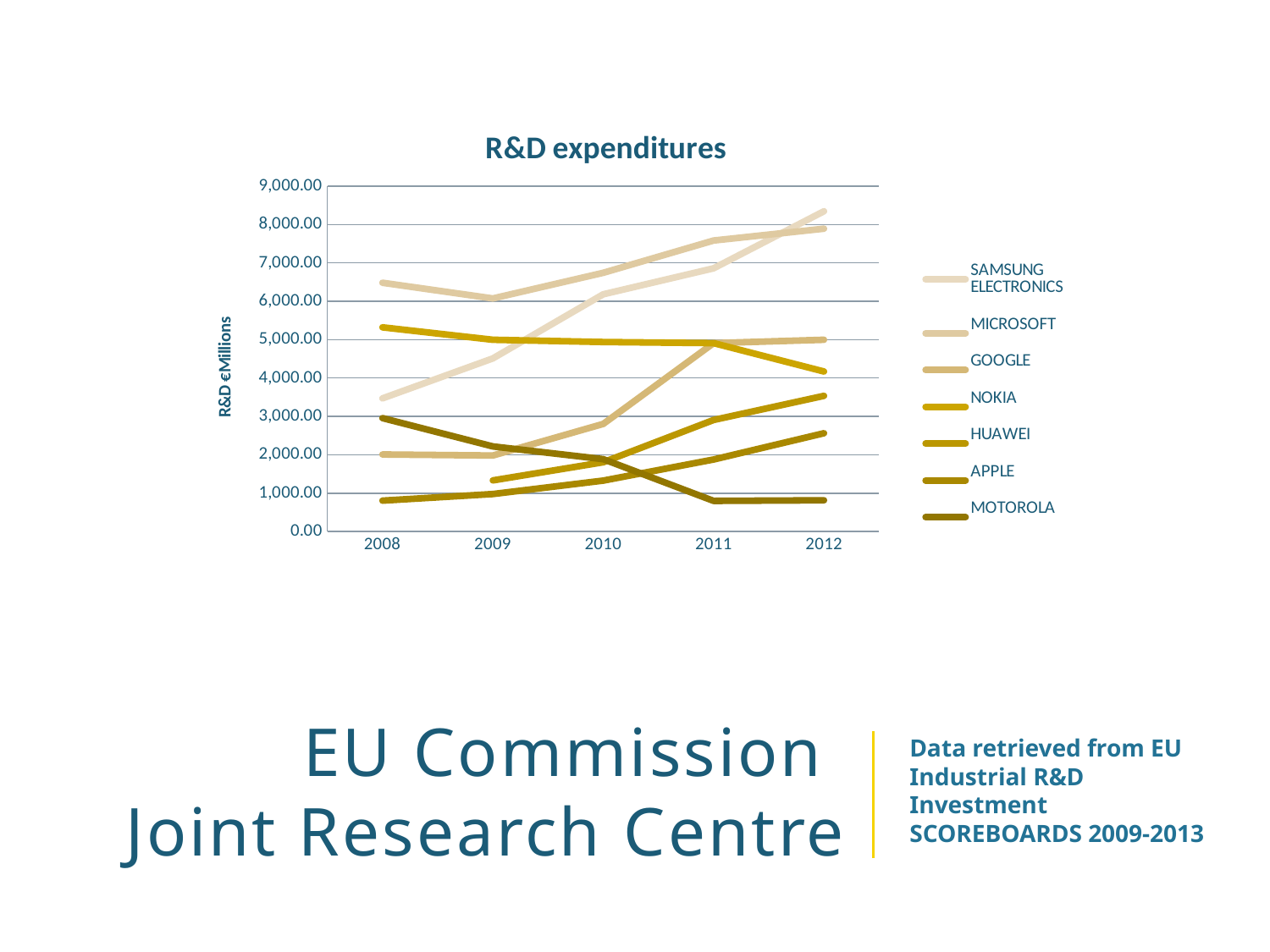
How many series does the legend of the R&D expenditures chart list? 7 Do the R&D expenditures of SAMSUNG ELECTRONICS rise or fall from 2008 to 2012? rise Is the value for NOKIA in 2012 greater or less than 5,000.00? less Do the R&D expenditures of MOTOROLA rise or fall from 2008 to 2012? fall Is the value for APPLE in 2008 greater or less than 1,000.00? less Which company has the lowest R&D expenditure in 2012? MOTOROLA What kind of chart is shown on the slide? line chart Which company has the highest R&D expenditure in 2008? MICROSOFT In 2010, which has the larger R&D expenditure, MICROSOFT or SAMSUNG ELECTRONICS? MICROSOFT Is the value for SAMSUNG ELECTRONICS in 2012 greater or less than 8,000.00? greater How many years are shown on the x axis of the R&D expenditures chart? 5 Which company has the highest R&D expenditure in 2012? SAMSUNG ELECTRONICS